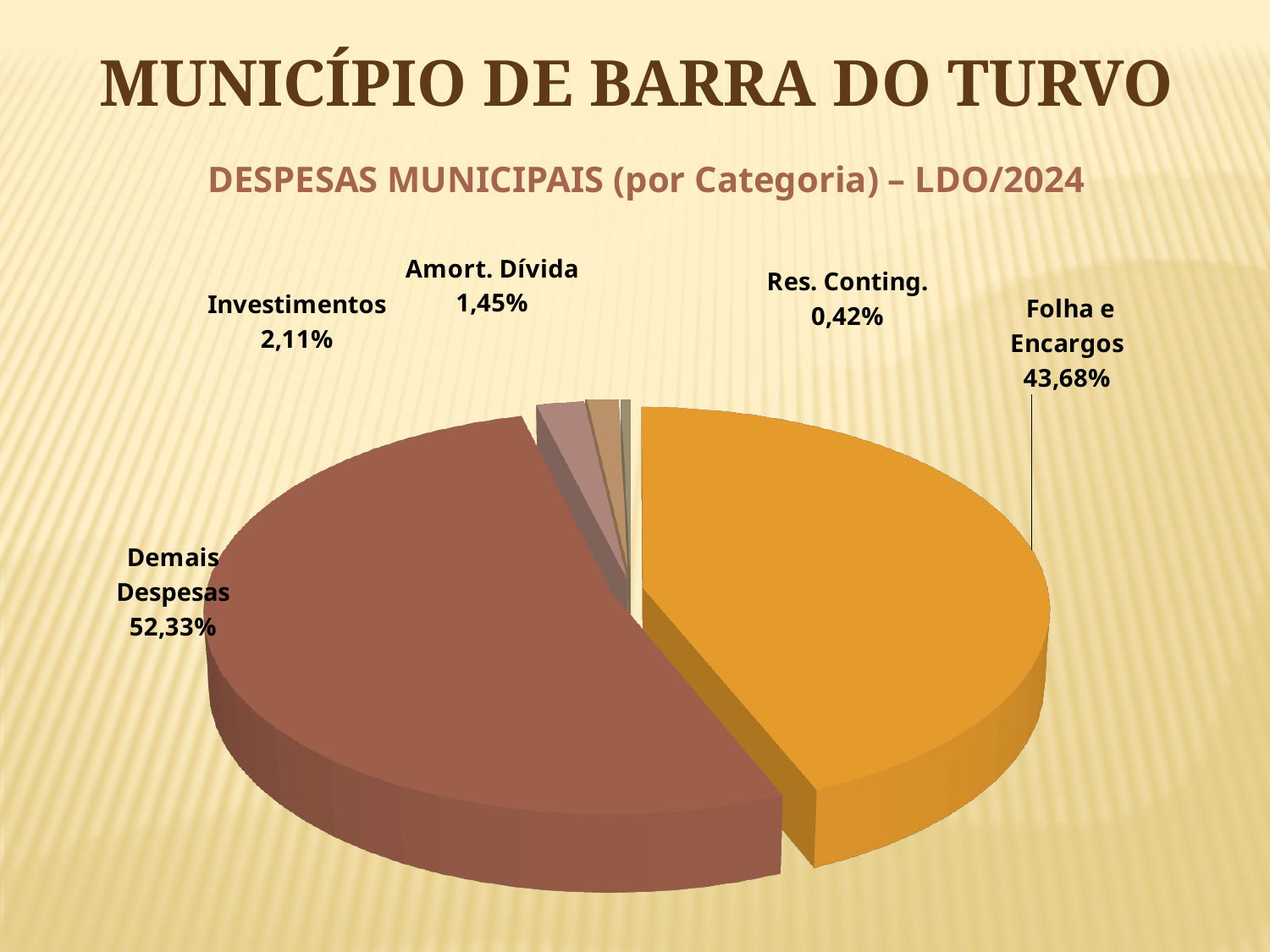
How many categories are shown in the pie chart? 5 What is the value shown for Folha e Encargos? 43,68% Which category has the smallest share of the pie? Res. Conting. What is the value shown for Amort. Dívida? 1,45% Which category has the largest share of the pie? Demais Despesas What is the value shown for Res. Conting.? 0,42% What is the difference between the shares of Demais Despesas and Folha e Encargos? 8,65% What is the value shown for Investimentos? 2,11% What share of the pie does Demais Despesas represent? 52,33% What is the title of the chart? DESPESAS MUNICIPAIS (por Categoria) – LDO/2024 What kind of chart is shown on the slide? Pie chart Which is larger, Investimentos or Amort. Dívida? Investimentos